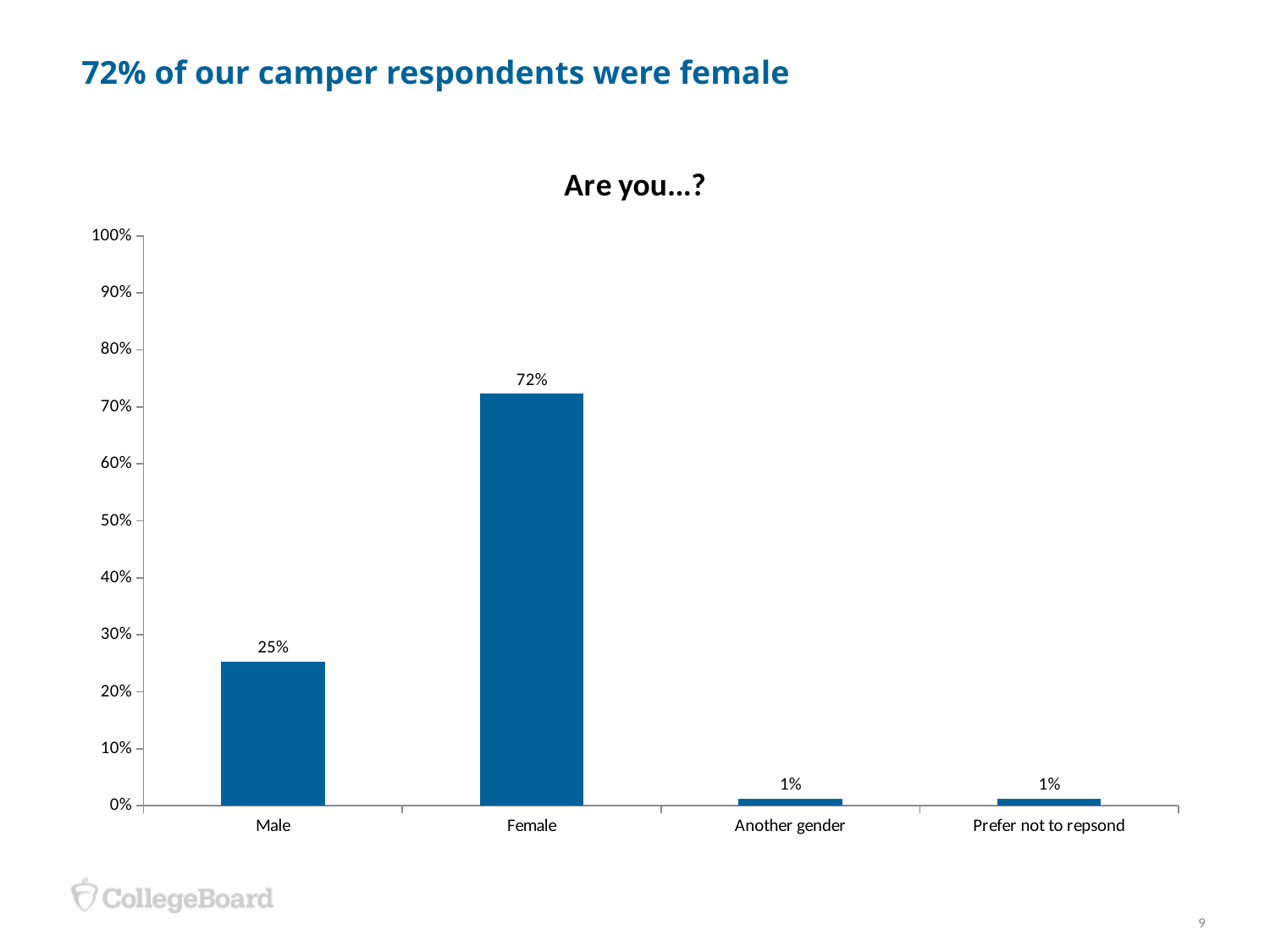
Which category has the highest value? Female What is the value shown for 'Another gender'? 1% Is the value for Female greater or less than 70%? greater Is the value for Male greater or less than 30%? less What is the difference between the Female and Male percentages? 47% What is the value shown for 'Prefer not to repsond'? 1% What percentage of camper respondents were male? 25% Which is larger, the value for Male or the value for Female? Female What percentage of camper respondents were female? 72% How many categories are shown on the x axis? 4 What kind of chart is shown on the slide? Bar chart What is the title of the chart? Are you...?